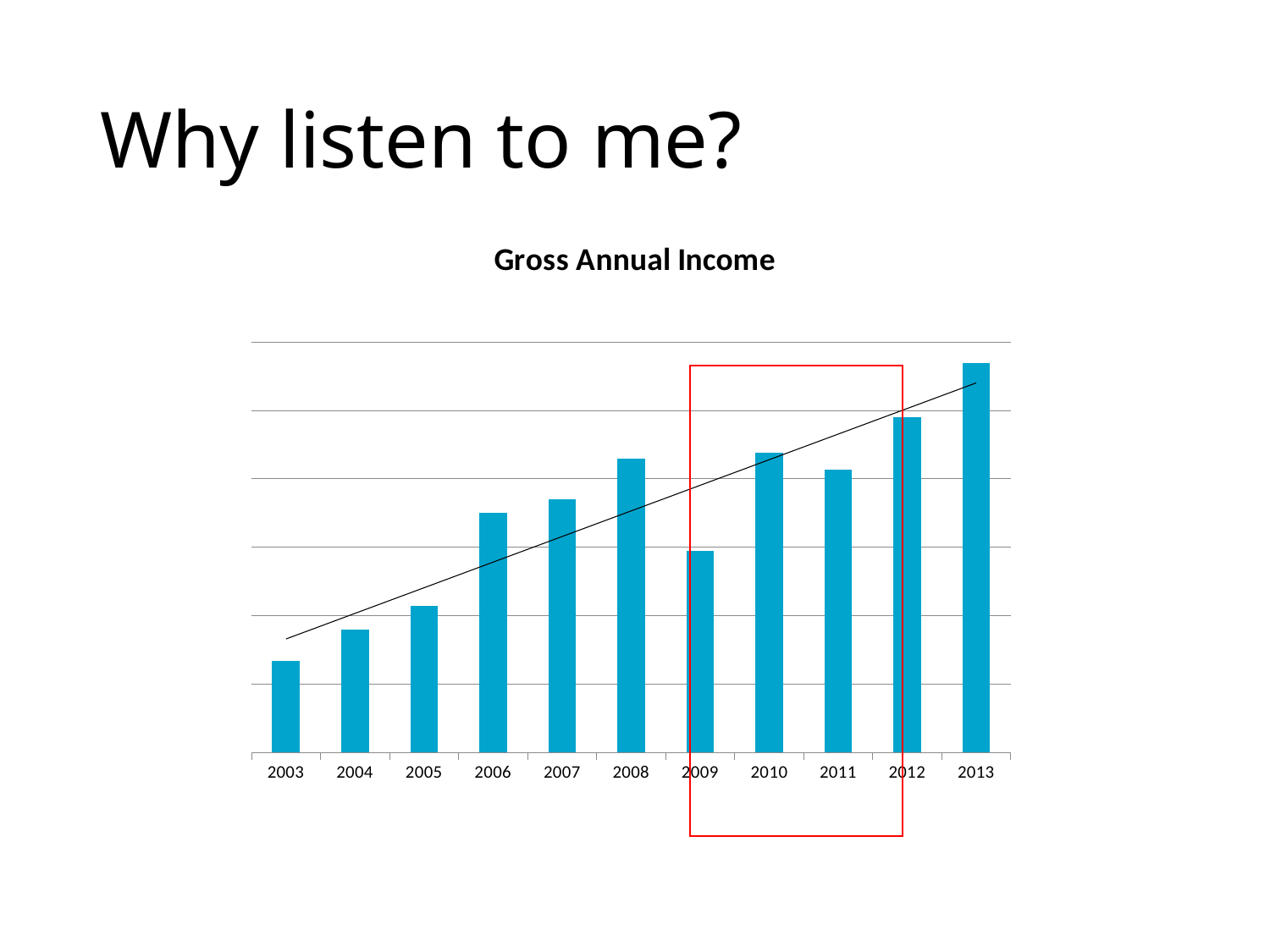
Does gross annual income generally rise or fall from 2003 to 2013? Rise Which year has the lowest gross annual income? 2003 Which year has the higher gross annual income, 2005 or 2006? 2006 Which year has the higher gross annual income, 2007 or 2009? 2007 Which years are enclosed by the red rectangle on the chart? 2009, 2010 and 2011 Which year has the higher gross annual income, 2008 or 2009? 2008 Which year has the highest gross annual income? 2013 What is the first year shown on the x axis? 2003 How many years are shown on the x axis of the chart? 11 What is the title of the chart? Gross Annual Income What kind of chart is shown on the slide? Bar chart